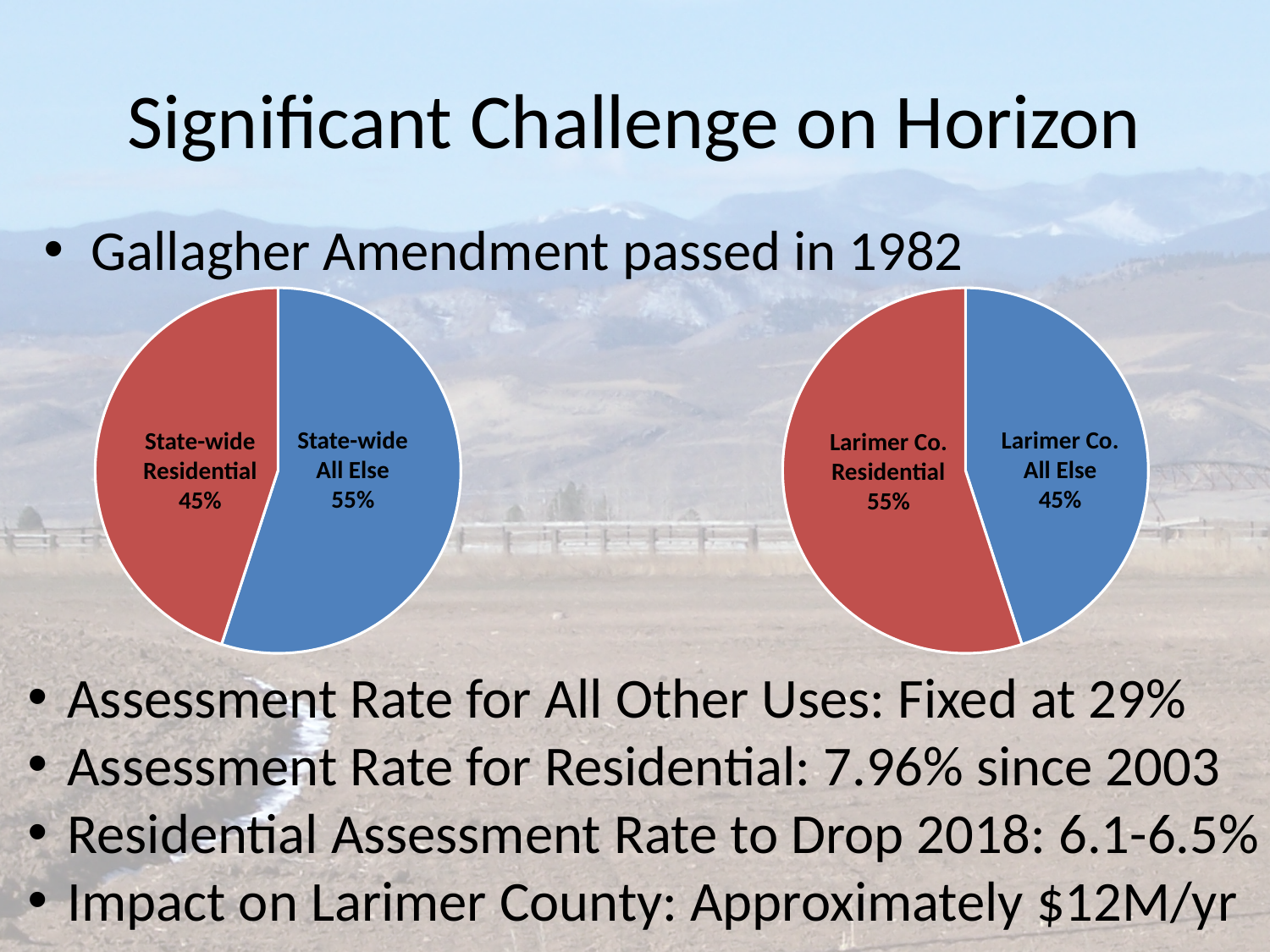
In the left pie chart, what is the difference between the State-wide All Else share and the State-wide Residential share? 10% What type of chart is the right chart on the slide? Pie chart In the right pie chart, what colour is the Larimer Co. Residential slice? Red In the right pie chart, which is larger: Larimer Co. Residential or Larimer Co. All Else? Larimer Co. Residential In the right pie chart, which slice is the smallest? Larimer Co. All Else In the left pie chart, which slice is the largest? State-wide All Else In the left pie chart, what share is labelled State-wide All Else? 55% In the left pie chart, what colour is the State-wide All Else slice? Blue In the left pie chart, what share is labelled State-wide Residential? 45% How many slices does the left pie chart have? 2 In the right pie chart, what share is labelled Larimer Co. All Else? 45% In the right pie chart, what share is labelled Larimer Co. Residential? 55%